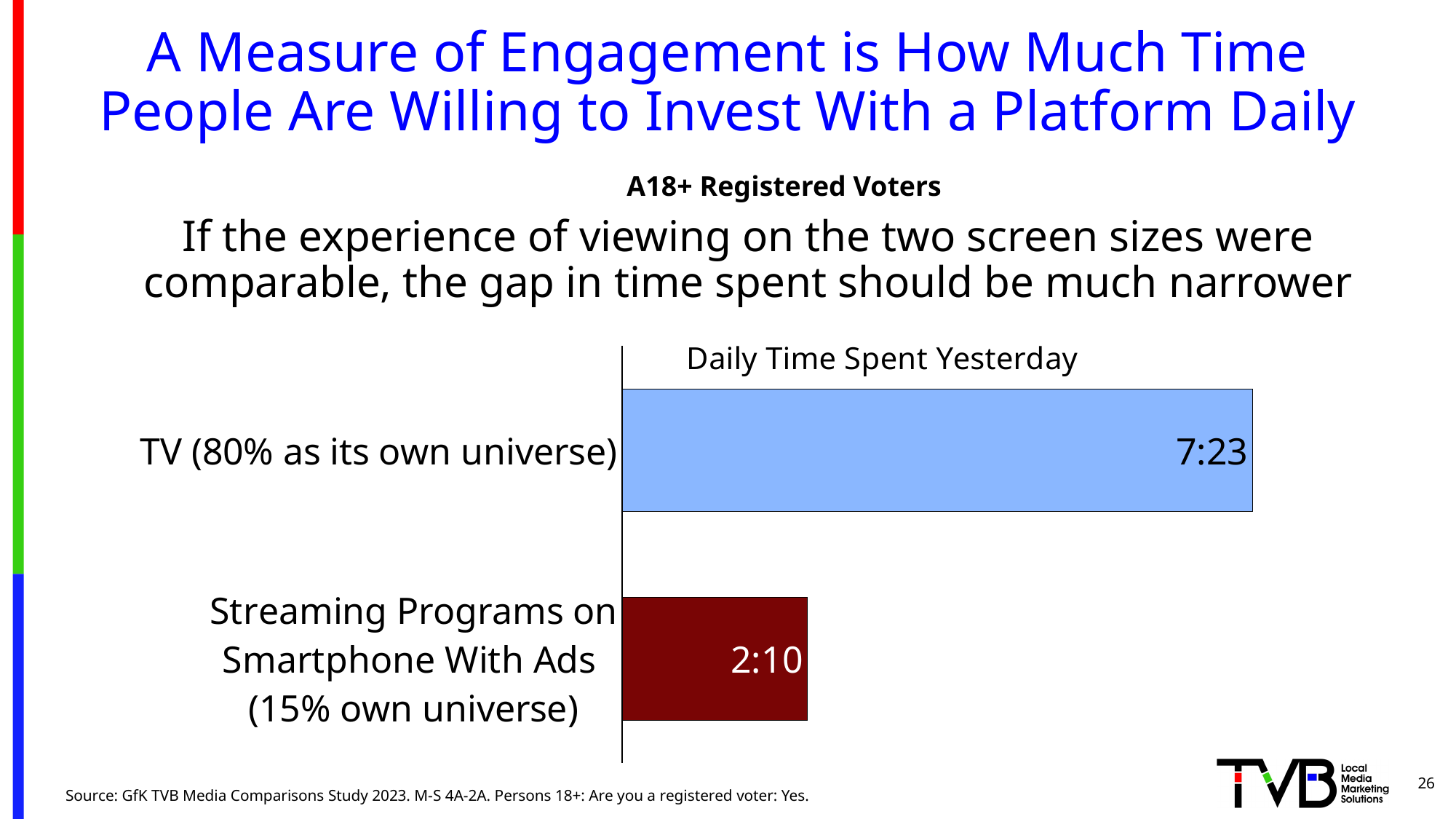
Which category has the lowest daily time spent yesterday? Streaming Programs on Smartphone With Ads (15% own universe) Which is larger: daily time spent on TV or on Streaming Programs on Smartphone With Ads? TV What is the daily time spent yesterday for TV (80% as its own universe)? 7:23 What is the title of the chart? Daily Time Spent Yesterday What kind of chart is shown on the slide? Bar chart Which category has the highest daily time spent yesterday? TV (80% as its own universe) What is the daily time spent yesterday for Streaming Programs on Smartphone With Ads (15% own universe)? 2:10 What is the difference in daily time spent between TV (7:23) and Streaming Programs on Smartphone With Ads (2:10)? 5:13 How many categories are shown in the chart? 2 What colour is the bar for Streaming Programs on Smartphone With Ads? Dark red